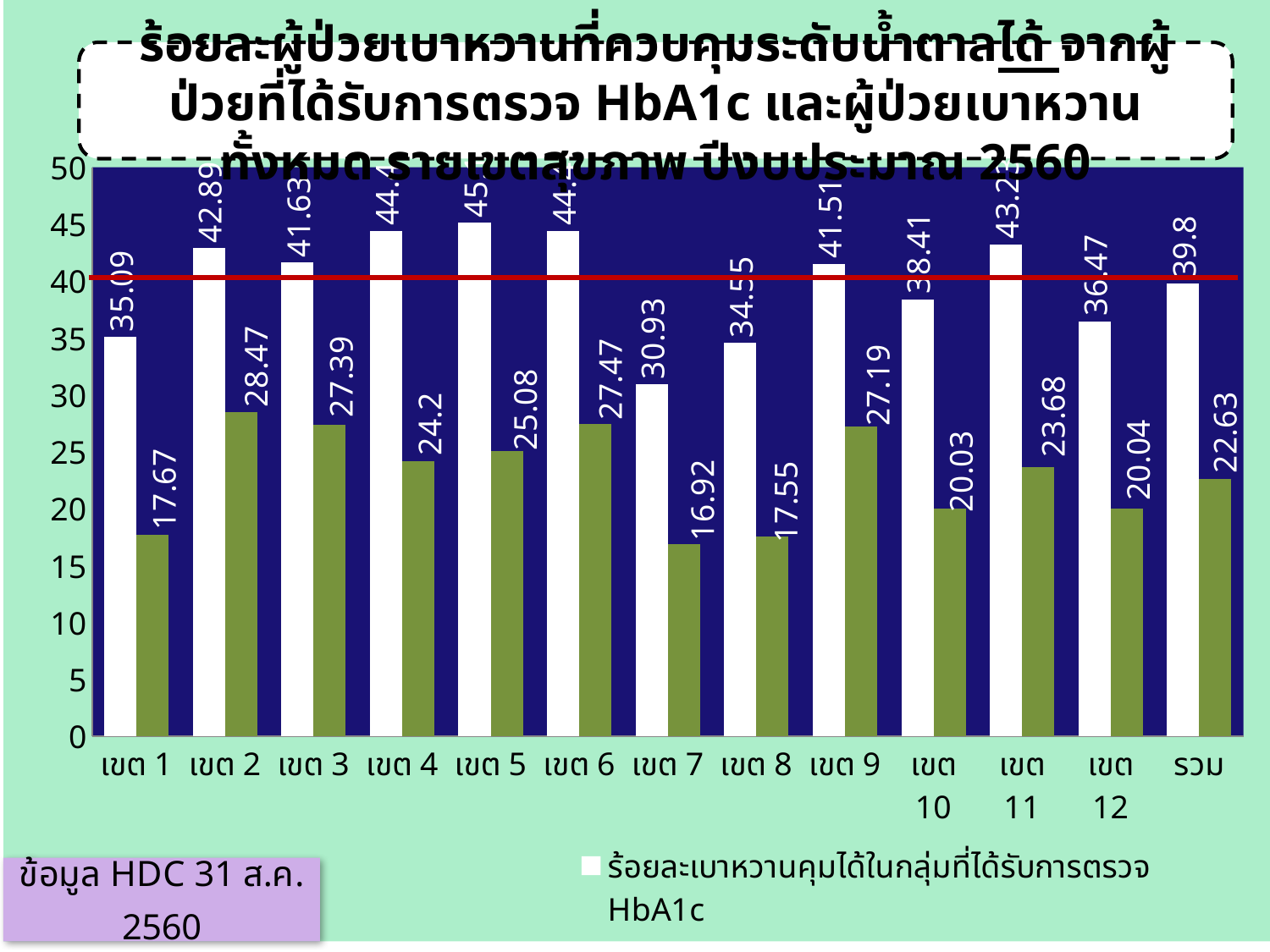
Which category has the highest green bar? เขต 2 What is the value of the white bar (ร้อยละเบาหวานคุมได้ในกลุ่มที่ได้รับการตรวจ HbA1c) for เขต 1? 35.09 At what value on the y axis is the red horizontal line drawn? 40 What is the value of the white bar for รวม? 39.8 What is the value of the green bar for เขต 2? 28.47 What is the difference between the white bar and the green bar for เขต 1? 17.42 Which has a higher white bar value, เขต 9 or เขต 10? เขต 9 Is the white bar value for เขต 7 greater or less than 40? less Which category has the lowest green bar? เขต 7 What kind of chart is shown on the slide? bar chart Which category has the lowest white bar (ร้อยละเบาหวานคุมได้ในกลุ่มที่ได้รับการตรวจ HbA1c)? เขต 7 How many categories are shown on the x axis? 13